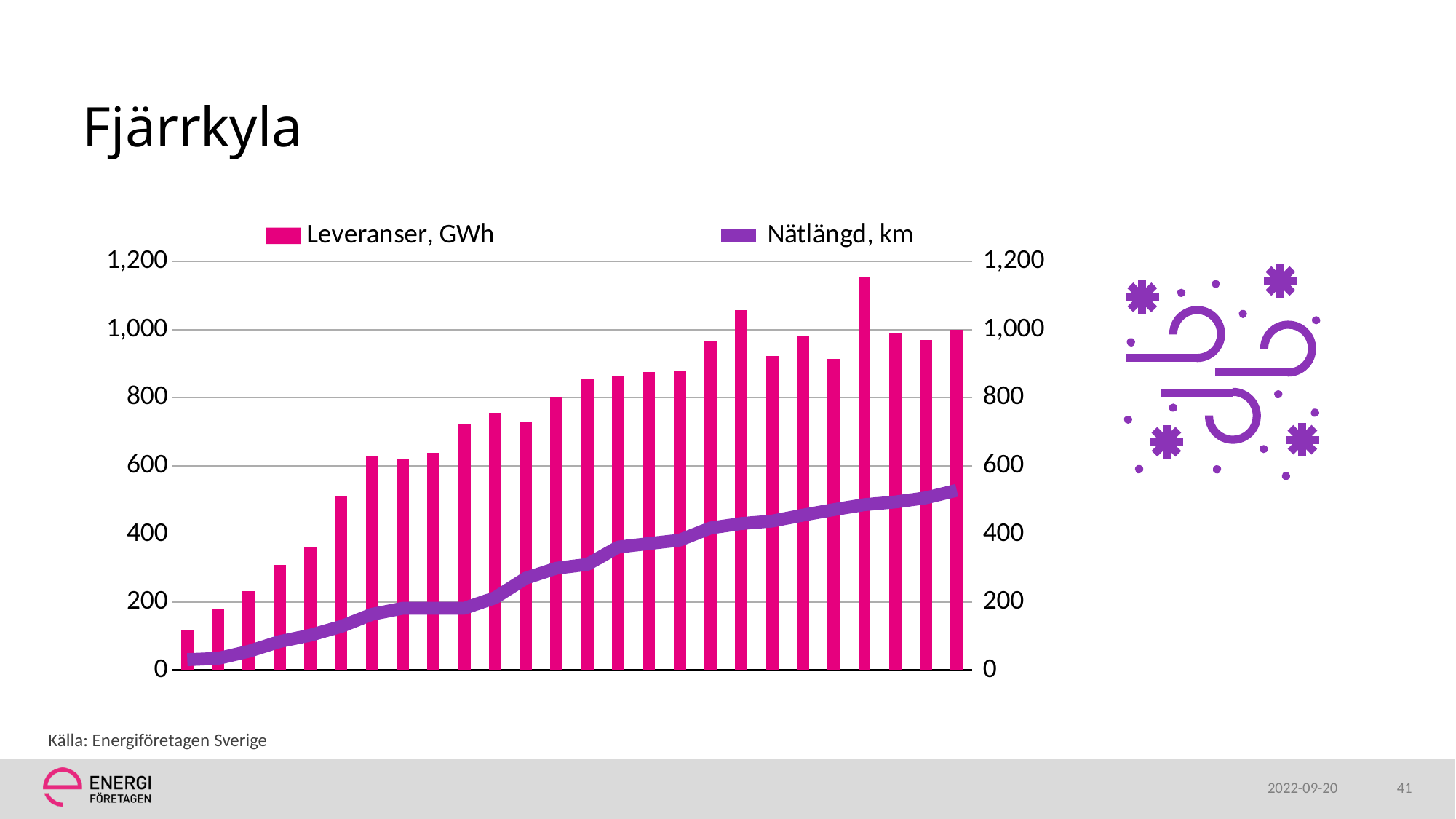
Is the rightmost Leveranser, GWh bar greater or less than 800? greater Is the final (rightmost) value of the Nätlängd, km line greater or less than 600? less What kind of chart is shown on the slide? A bar chart combined with a line What are the two series named in the legend? Leveranser, GWh and Nätlängd, km Is the final (rightmost) value of the Nätlängd, km line greater or less than 400? greater How many series does the legend list? 2 What is the title of the slide containing the chart? Fjärrkyla What is the highest value shown on the vertical axis? 1,200 Do the Leveranser, GWh bars generally rise or fall from left to right? Rise Does the Nätlängd, km line rise or fall from left to right? Rise